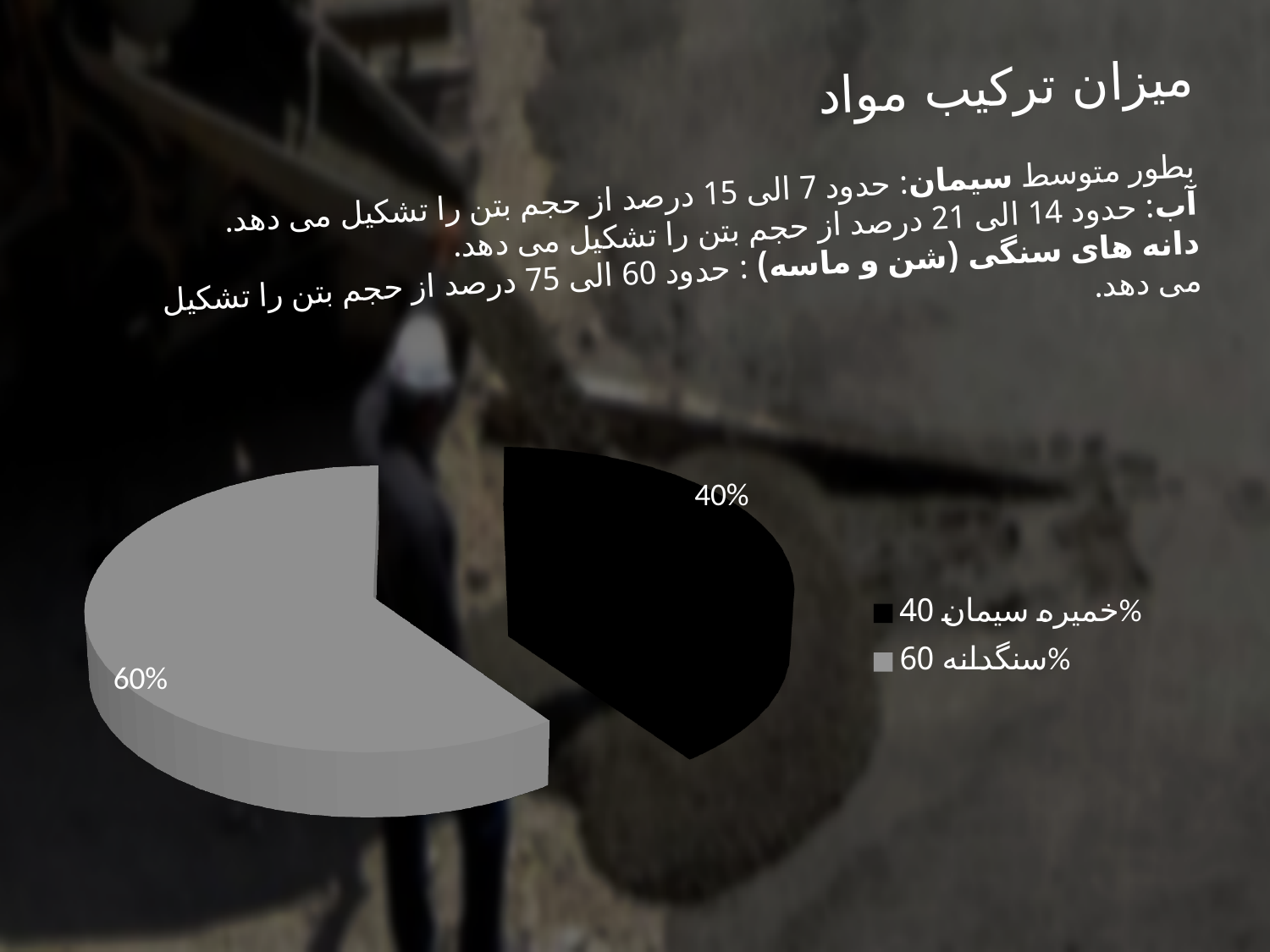
What share of the pie does the سنگدانه slice represent? 60% How many entries does the legend of the pie chart list? 2 Which slice of the pie chart is the smallest? خمیره سیمان What is the difference between the سنگدانه slice and the خمیره سیمان slice? 20% What is the value shown for the خمیره سیمان slice? 40% What is the total of the two slices shown in the pie chart? 100% What kind of chart is shown on the slide? pie chart Which slice of the pie chart is the largest? سنگدانه How many slices does the pie chart have? 2 Which is larger, the خمیره سیمان slice or the سنگدانه slice? سنگدانه What colour is the خمیره سیمان slice in the pie chart? black What is the value shown for the سنگدانه slice? 60%